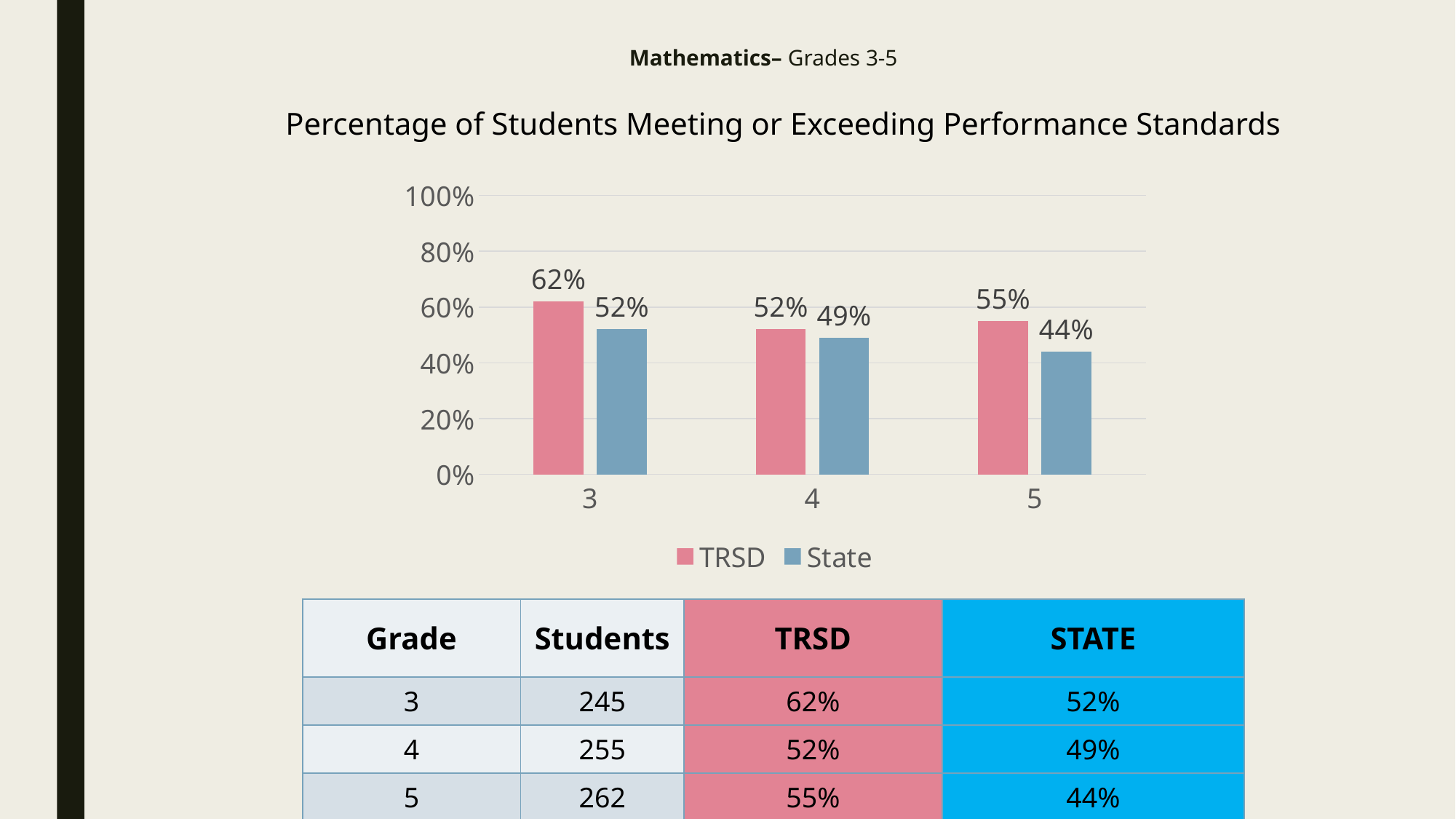
What is the difference between the TRSD values for grade 3 and grade 4? 10% Do the State values rise or fall from grade 3 to grade 5? fall Which grade has the lowest State value? 5 Which grade has the highest TRSD value? 3 Which is larger, the TRSD value for grade 4 or the State value for grade 4? TRSD What is the State value for grade 4? 49% What is the State value for grade 5? 44% What is the difference between the TRSD and State values for grade 5? 11% How many series does the chart legend list? 2 What kind of chart is shown on the slide? bar chart How many grades are shown on the x axis of the chart? 3 What is the TRSD value for grade 3? 62%